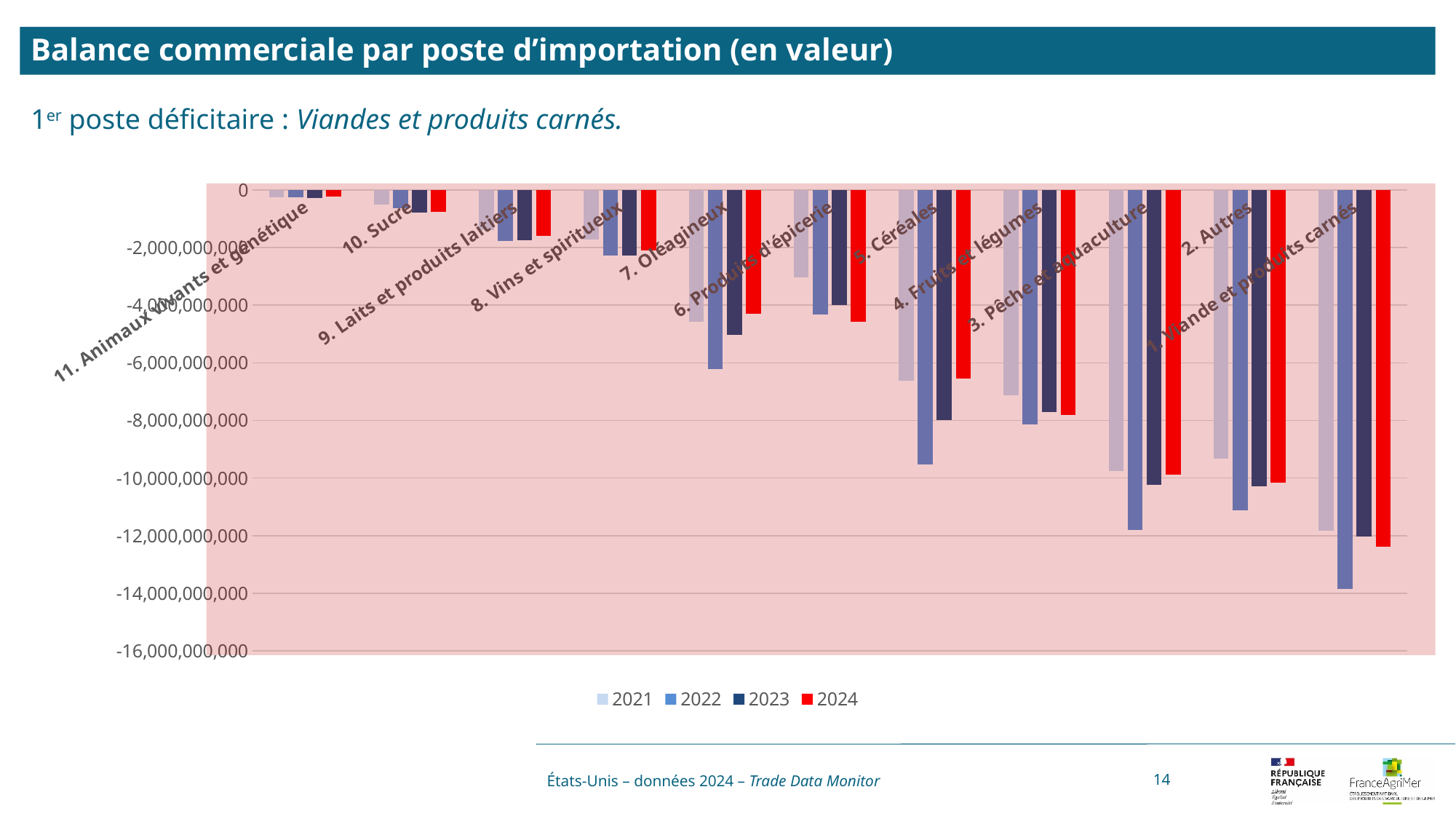
What kind of chart is shown on the slide? bar chart How many import categories are plotted on the x axis? 11 Do the values generally rise or fall moving from left to right along the x axis? fall For 2024, which category has the more negative value, 5. Céréales or 4. Fruits et légumes? 4. Fruits et légumes Which category has the lowest (most negative) bar in the whole chart? 1. Viande et produits carnés Is the 2021 value for 10. Sucre greater or less than -2,000,000,000? greater How many series does the legend list? 4 For 1. Viande et produits carnés, which year has the more negative value, 2022 or 2024? 2022 Is the 2022 value for 1. Viande et produits carnés greater or less than -12,000,000,000? less Is the 2024 value for 5. Céréales greater or less than -4,000,000,000? less Which colour represents the 2024 series in the legend? red Which category has the bar closest to zero for 2024? 11. Animaux vivants et génétique